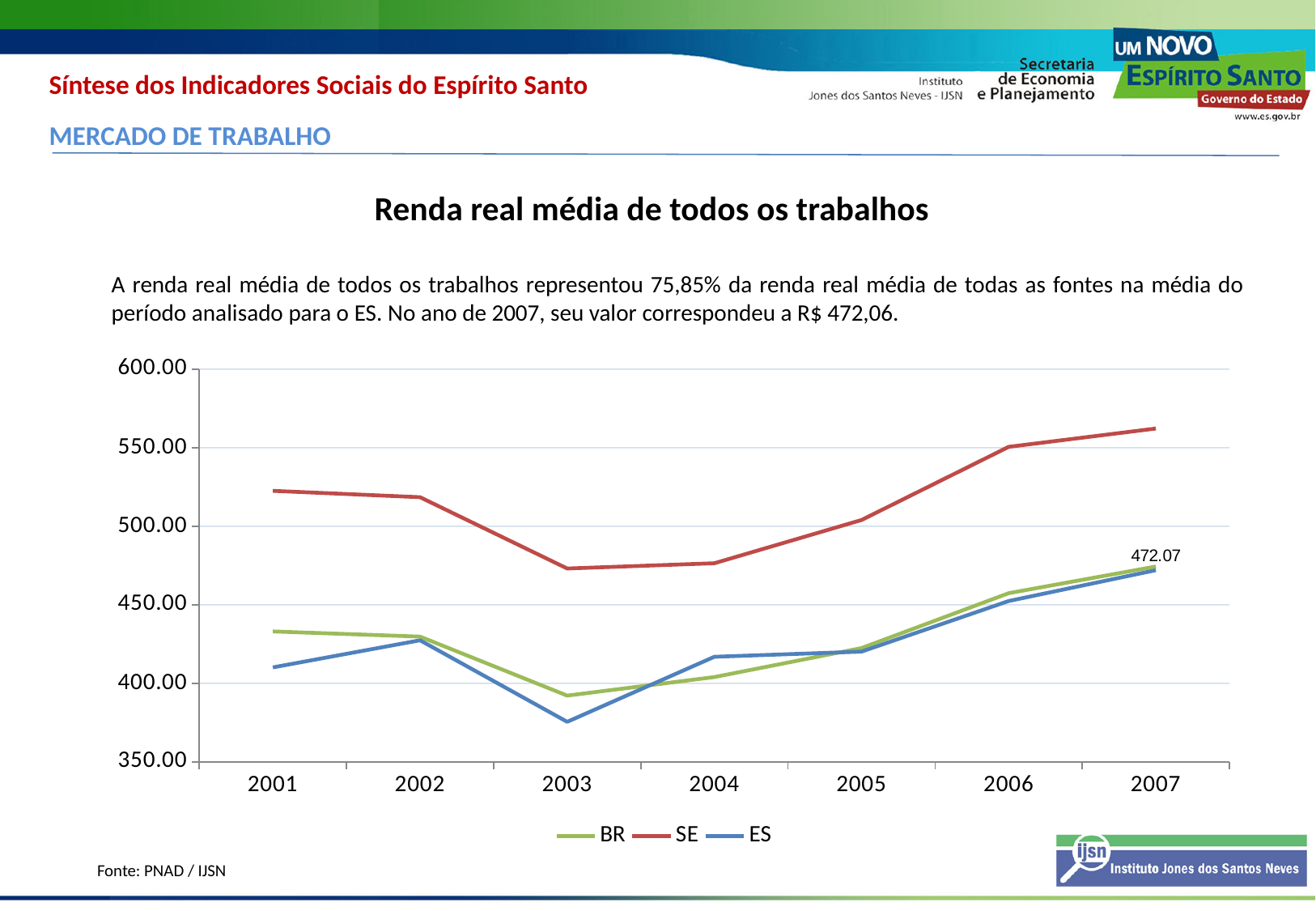
How many series does the legend list? 3 What kind of chart is shown on the slide? line chart How many years are plotted along the x axis? 7 What is the value for ES in 2007? 472.07 Is the value for SE in 2001 greater or less than 500.00? greater Which is larger in 2001, the value for BR or the value for ES? BR What is the title of the chart? Renda real média de todos os trabalhos In which year does the SE series reach its lowest value? 2003 Does the SE series rise or fall from 2003 to 2007? rise Is the value for ES in 2003 greater or less than 400.00? less Which series has the highest value in 2007? SE In which year does the ES series reach its lowest value? 2003